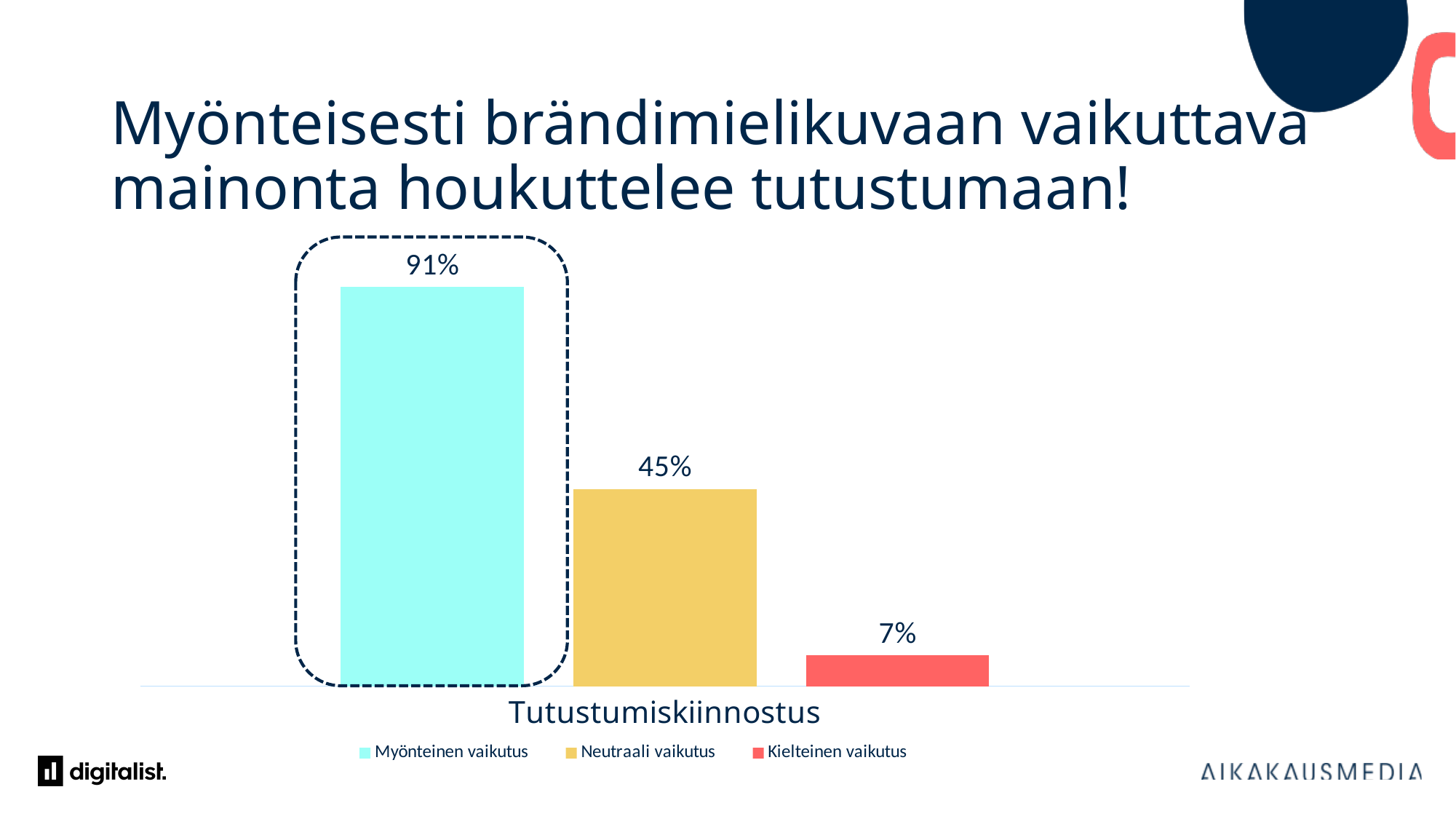
Which is larger, the value for Neutraali vaikutus or Kielteinen vaikutus? Neutraali vaikutus What is the value for Myönteinen vaikutus? 91% What is the value for Kielteinen vaikutus? 7% Which series has the lowest value? Kielteinen vaikutus What kind of chart is shown on the slide? Bar chart What is the difference between the values for Neutraali vaikutus and Kielteinen vaikutus? 38% How many series does the legend list? 3 What is the value for Neutraali vaikutus? 45% What is the category label shown on the x axis? Tutustumiskiinnostus Which series is highlighted with a dashed outline? Myönteinen vaikutus Which series has the highest value? Myönteinen vaikutus What is the difference between the values for Myönteinen vaikutus and Neutraali vaikutus? 46%